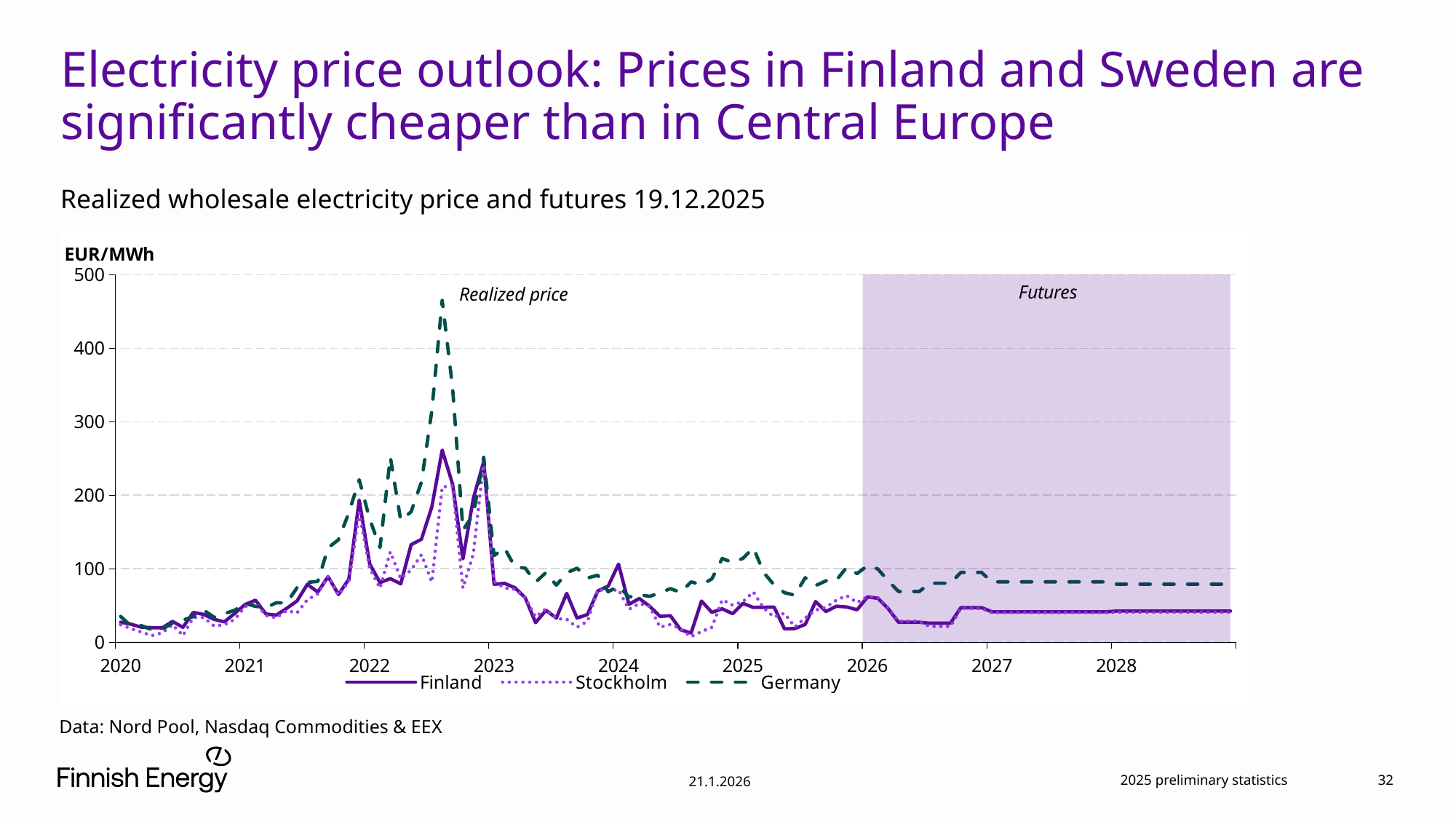
Is the peak value for Germany in 2022 greater or less than 400? greater Do the prices for Finland rise or fall from the 2022 peak to 2024? fall Is the futures value for Germany in 2028 greater or less than 50? greater How many year labels are shown on the x axis? 9 In the futures period, which is higher: the Germany line or the Finland line? Germany Is the peak value for Finland in 2022 greater or less than 200? greater Which series reaches the highest peak in the chart? Germany What unit is shown on the y axis of the chart? EUR/MWh How many series does the legend list? 3 What kind of chart is shown on the slide? Line chart Which series are listed in the legend? Finland, Stockholm, Germany